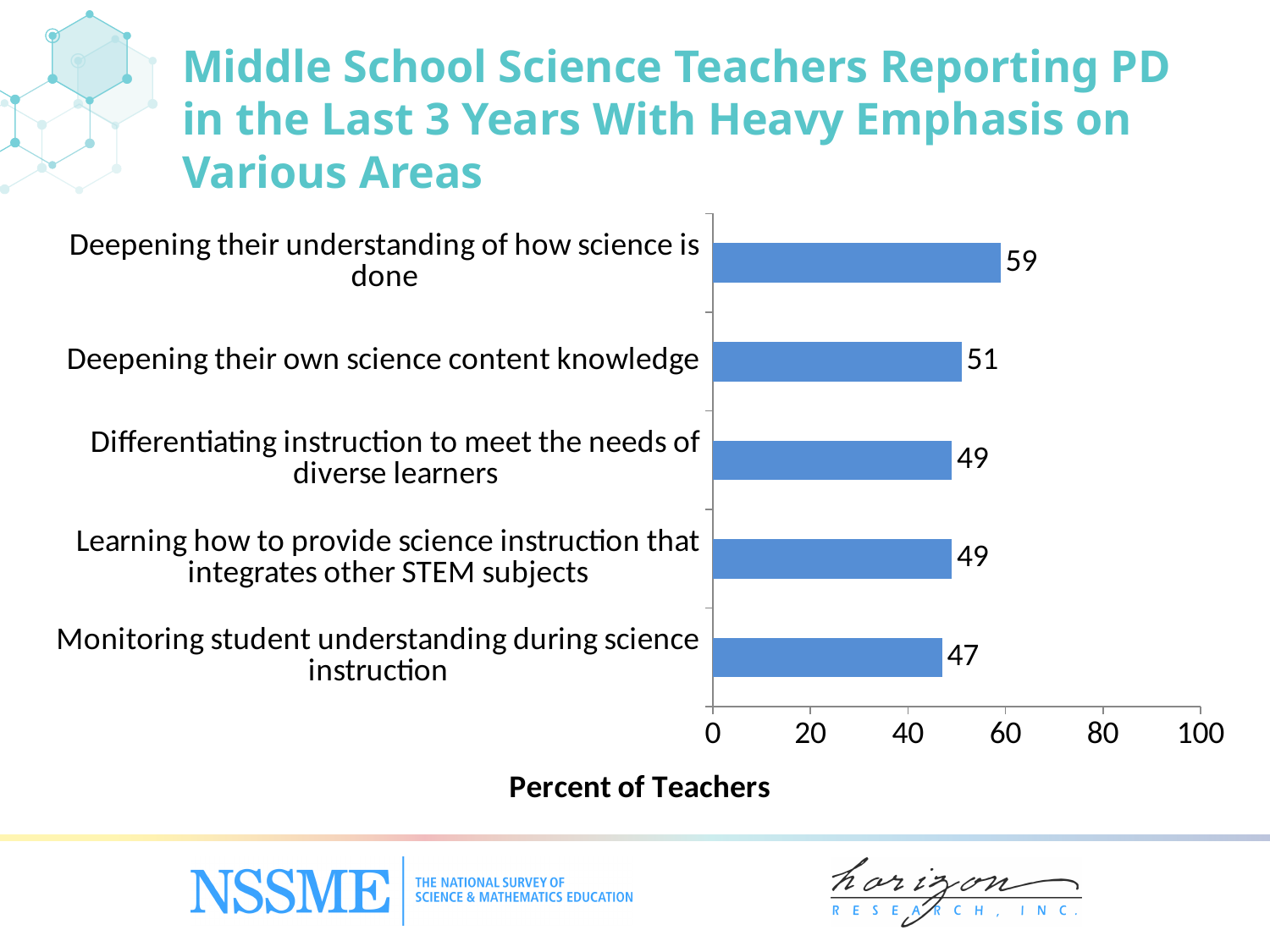
What percent of teachers reported PD with heavy emphasis on deepening their understanding of how science is done? 59 Which area has the highest percent of teachers? Deepening their understanding of how science is done What is the value for 'Deepening their own science content knowledge'? 51 Which is larger: the value for 'Deepening their own science content knowledge' or the value for 'Monitoring student understanding during science instruction'? Deepening their own science content knowledge What kind of chart is shown on the slide? Bar chart Is the value for 'Deepening their understanding of how science is done' greater or less than 40? greater What is the value for 'Monitoring student understanding during science instruction'? 47 What is the difference between the values for 'Deepening their own science content knowledge' and 'Differentiating instruction to meet the needs of diverse learners'? 2 Which area has the lowest percent of teachers? Monitoring student understanding during science instruction What is the label of the horizontal axis? Percent of Teachers How many areas are shown in the chart? 5 What is the difference between the values for 'Deepening their understanding of how science is done' and 'Monitoring student understanding during science instruction'? 12